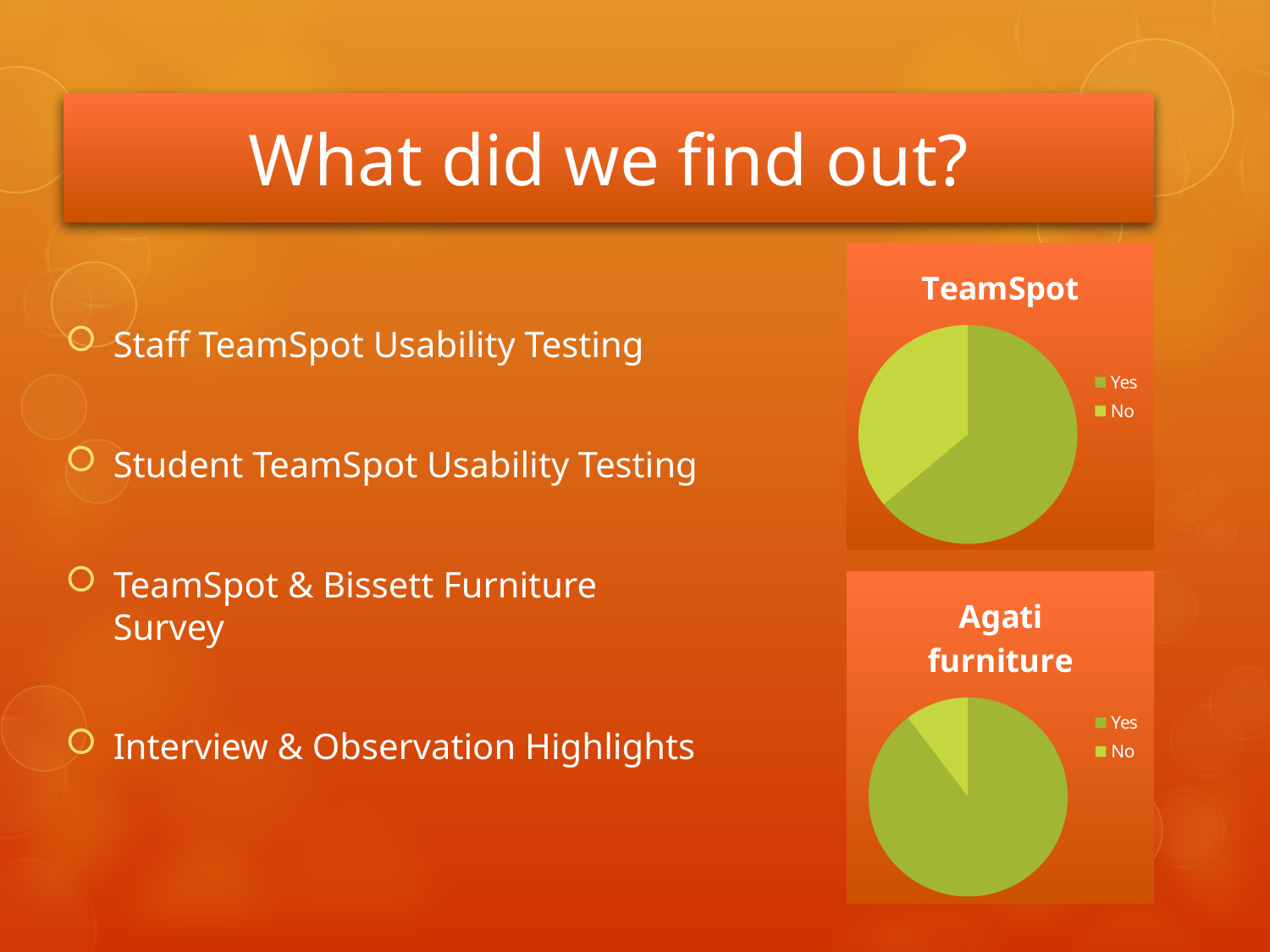
In the TeamSpot chart, what are the two legend entries? Yes, No What kind of chart is the TeamSpot chart? pie chart In the Agati furniture chart, which slice is the smallest? No In the TeamSpot chart, which slice is the largest? Yes In the TeamSpot chart, which slice is the smallest? No What kind of chart is the Agati furniture chart? pie chart In the TeamSpot chart, which is larger, the Yes slice or the No slice? Yes In the Agati furniture chart, which slice is the largest? Yes What is the title of the lower chart on the slide? Agati furniture In the Agati furniture chart, which is larger, the Yes slice or the No slice? Yes In the Agati furniture chart, how many entries does the legend list? 2 In the TeamSpot chart, how many slices does the pie have? 2